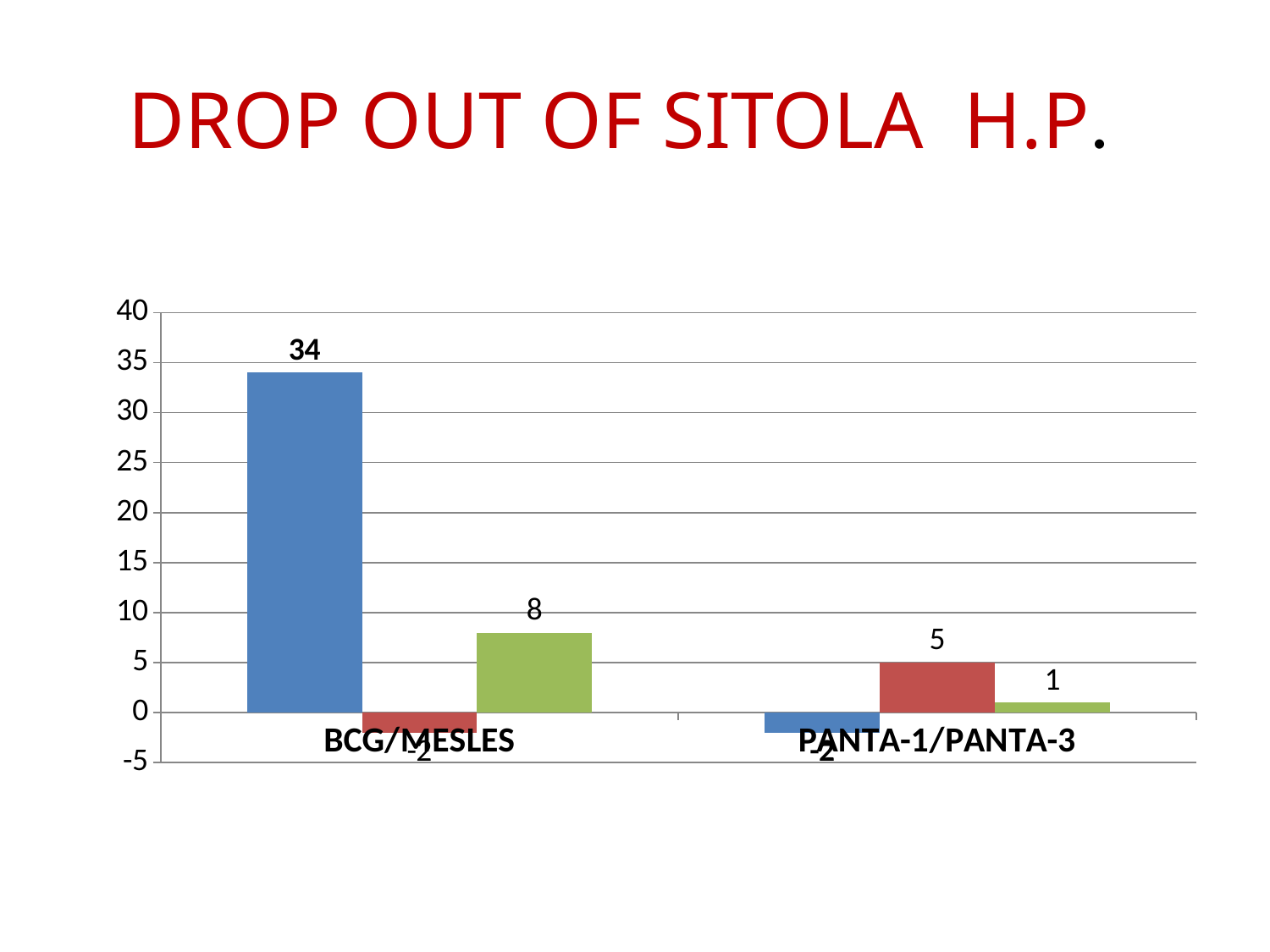
What is the title of the slide? DROP OUT OF SITOLA H.P. What is the value of the green bar for BCG/MESLES? 8 What is the value of the red bar for BCG/MESLES? -2 What is the value of the green bar for PANTA-1/PANTA-3? 1 What is the difference between the red bar and the green bar for PANTA-1/PANTA-3? 4 Which is larger, the green bar for BCG/MESLES or the red bar for PANTA-1/PANTA-3? the green bar for BCG/MESLES What is the value of the red bar for PANTA-1/PANTA-3? 5 What kind of chart is shown on the slide? bar chart What is the value of the blue bar for BCG/MESLES? 34 Which category has the highest bar on the chart? BCG/MESLES How many categories are shown on the x axis? 2 What is the difference between the blue bar and the green bar for BCG/MESLES? 26